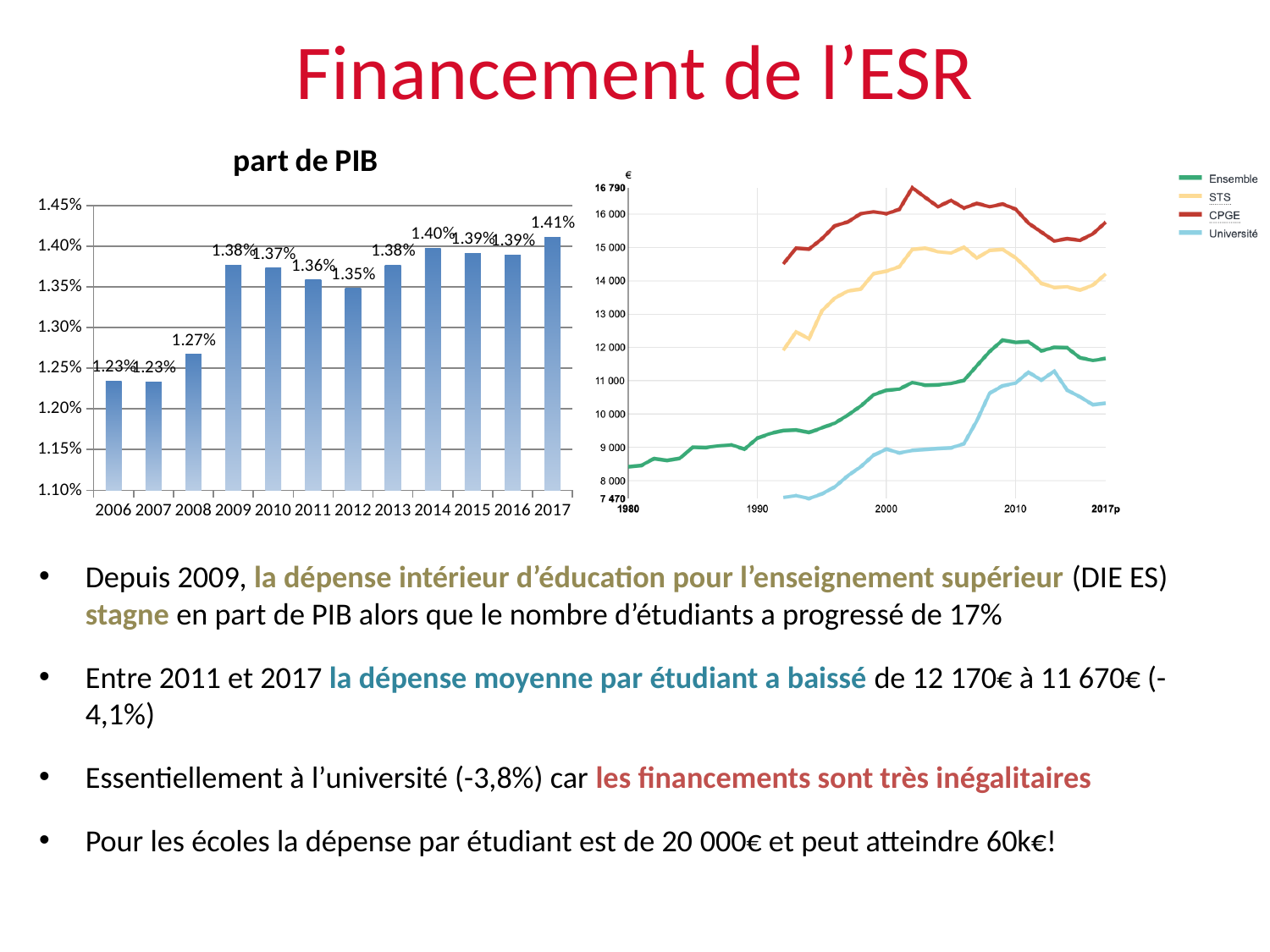
How many series does the legend of the line chart on the right list? 4 In the line chart on the right, is the value for CPGE in 2010 greater or less than 15 000? greater In the 'part de PIB' bar chart, which year has the larger value, 2014 or 2015? 2014 In the 'part de PIB' bar chart, what is the value for 2012? 1.35% In the 'part de PIB' bar chart, what is the value for 2017? 1.41% In the line chart on the right, which series has the highest values? CPGE In the 'part de PIB' bar chart, what is the value for 2008? 1.27% What kind of chart is the 'part de PIB' chart on the left? bar chart How many years are shown in the 'part de PIB' bar chart? 12 In the 'part de PIB' bar chart, which year has the highest value? 2017 In the 'part de PIB' bar chart, what is the difference between the 2017 value and the 2006 value? 0.18% In the 'part de PIB' bar chart, do the values rise or fall from 2006 to 2009? rise